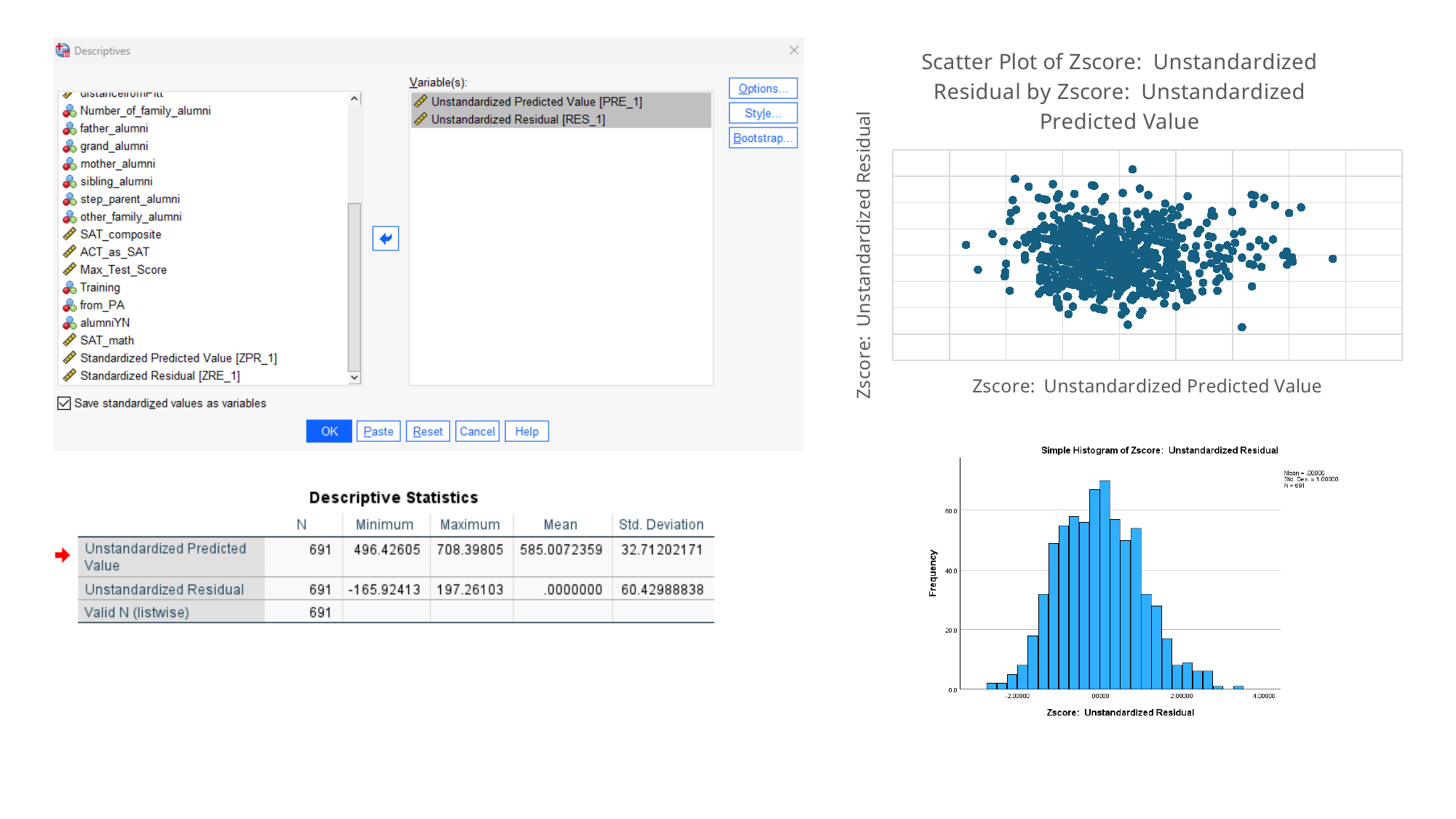
In the scatter plot, what is the label of the x axis? Zscore: Unstandardized Predicted Value In the histogram, what value of N is printed in the annotation? 691 In the histogram, is the frequency of the bar at the 2.00000 tick greater or less than 20? less What kind of chart is the 'Simple Histogram of Zscore: Unstandardized Residual' chart? bar chart (histogram) In the histogram, is the frequency of the tallest bar greater or less than 60? greater In the histogram, do the bar heights rise or fall as the x axis goes from -2.00000 to .00000? rise In the histogram, is the frequency of the bar at the -2.00000 tick greater or less than 20? less In the histogram, do the bar heights rise or fall as the x axis goes from .00000 to 2.00000? fall In the histogram, what is the label of the y axis? Frequency In the histogram, near which x-axis tick is the tallest bar located? .00000 In the histogram, what Std. Dev. value is printed in the annotation? 1.00000 What kind of chart is the chart at the top right of the slide? scatter plot